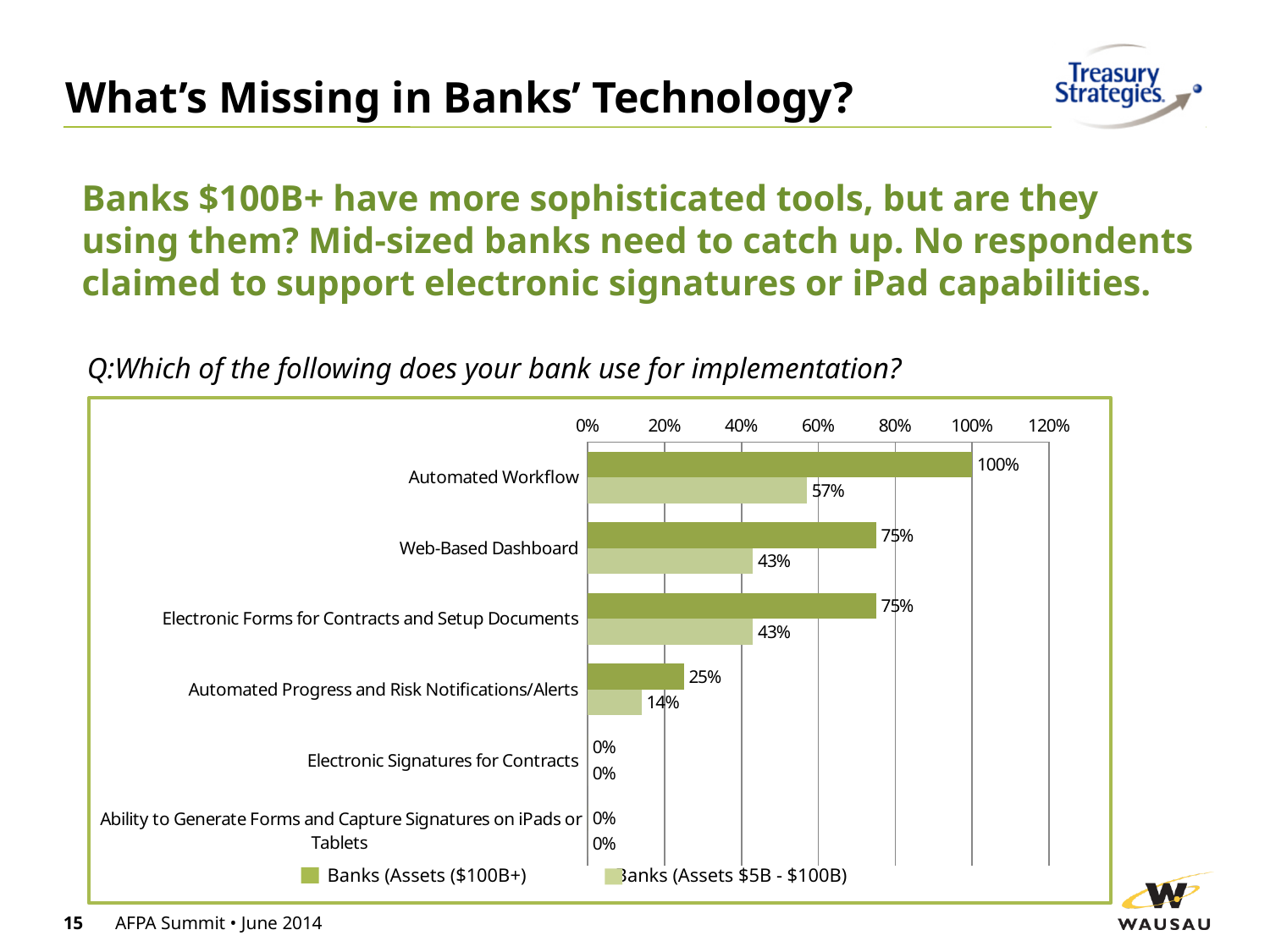
What is the difference between the two series' values for Automated Progress and Risk Notifications/Alerts? 11% Which category has the highest value for Banks (Assets $5B - $100B)? Automated Workflow Which is larger: the Banks (Assets $100B+) value for Web-Based Dashboard or the Banks (Assets $5B - $100B) value for Automated Workflow? Banks (Assets $100B+) value for Web-Based Dashboard What is the value for Automated Progress and Risk Notifications/Alerts for Banks (Assets $100B+)? 25% What is the value for Web-Based Dashboard for Banks (Assets $5B - $100B)? 43% How many series does the legend list? 2 How many categories are shown on the chart? 6 What kind of chart is shown on the slide? Bar chart What is the value for Automated Workflow for Banks (Assets $100B+)? 100% What is the value for Electronic Signatures for Contracts for Banks (Assets $100B+)? 0% What is the difference between the Banks (Assets $100B+) and Banks (Assets $5B - $100B) values for Automated Workflow? 43% What question is the chart based on, as shown above it? Which of the following does your bank use for implementation?